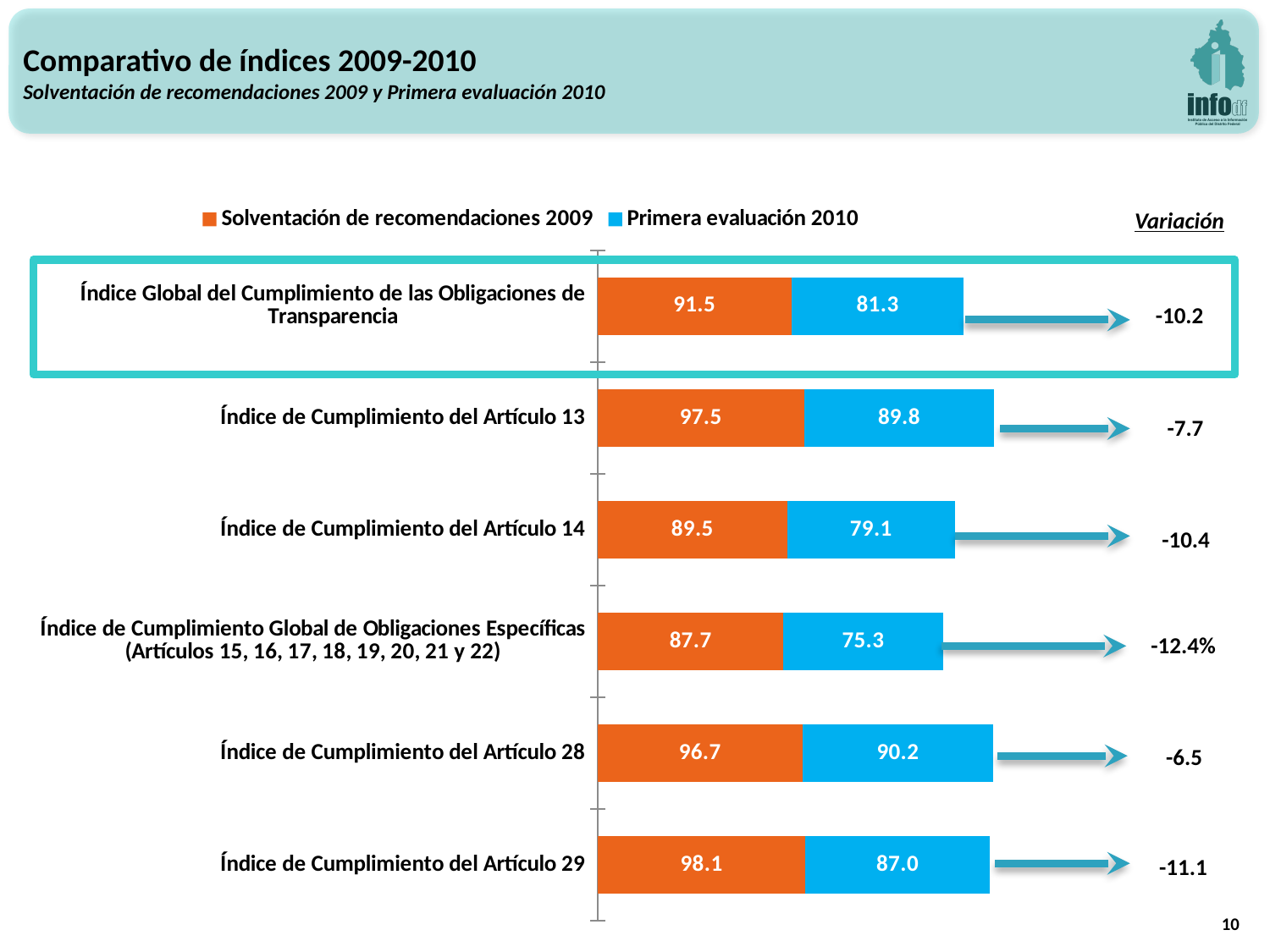
What colour represents the Primera evaluación 2010 series in the chart? blue What is the Primera evaluación 2010 value for Índice de Cumplimiento del Artículo 14? 79.1 What is the Primera evaluación 2010 value for Índice Global del Cumplimiento de las Obligaciones de Transparencia? 81.3 Which category has the highest Solventación de recomendaciones 2009 value? Índice de Cumplimiento del Artículo 29 What kind of chart is shown on the slide? bar chart How many categories (índices) are plotted in the chart? 6 What is the Solventación de recomendaciones 2009 value for Índice de Cumplimiento del Artículo 13? 97.5 What is the Variación shown for Índice de Cumplimiento del Artículo 29? -11.1 What is the difference between the 2009 and 2010 values for Índice de Cumplimiento del Artículo 28? 6.5 Which has the larger Solventación de recomendaciones 2009 value: Índice de Cumplimiento del Artículo 14 or Índice de Cumplimiento del Artículo 29? Índice de Cumplimiento del Artículo 29 Which category has the lowest Primera evaluación 2010 value? Índice de Cumplimiento Global de Obligaciones Específicas (Artículos 15, 16, 17, 18, 19, 20, 21 y 22) How many series does the legend list? 2